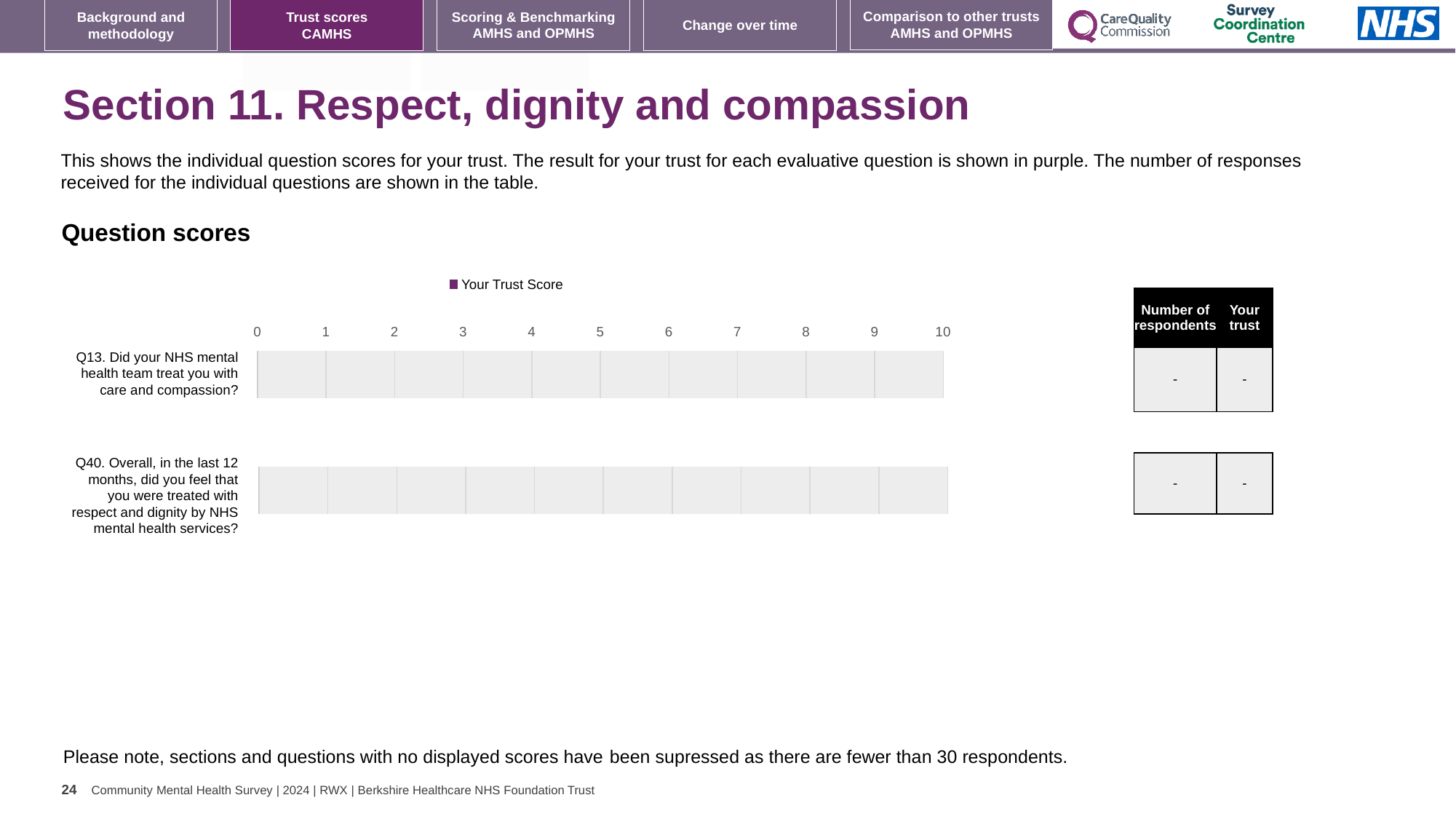
How many series does the chart legend list? 1 How many questions (categories) are listed on the chart's vertical axis? 2 According to the table, what is the "Your trust" score shown for Q40? - According to the table, what is the number of respondents shown for Q13? - What is the maximum value shown on the chart's horizontal axis? 10 What is the name of the series shown in the chart legend? Your Trust Score What kind of chart is shown under "Question scores"? bar chart